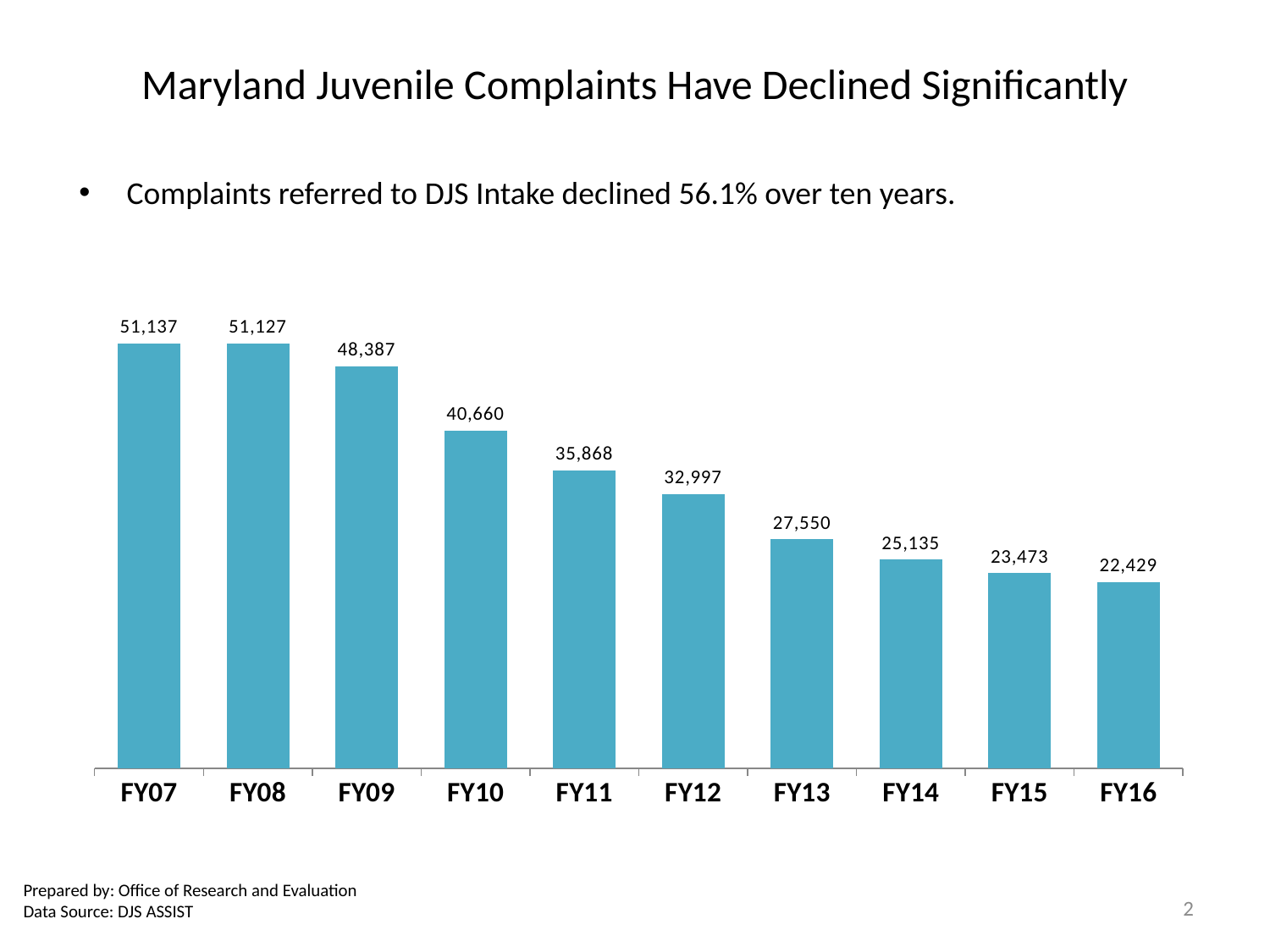
How many fiscal years are shown on the chart? 10 What is the value for FY16? 22,429 What is the title of the slide? Maryland Juvenile Complaints Have Declined Significantly What is the difference between the values for FY10 and FY11? 4,792 What kind of chart is shown on the slide? Bar chart Do the values rise or fall from FY07 to FY16? Fall What is the value for FY10? 40,660 What is the value for FY13? 27,550 What is the difference between the values for FY07 and FY16? 28,708 Which is larger, the value for FY09 or the value for FY12? FY09 Which fiscal year has the lowest value? FY16 What is the value for FY07? 51,137